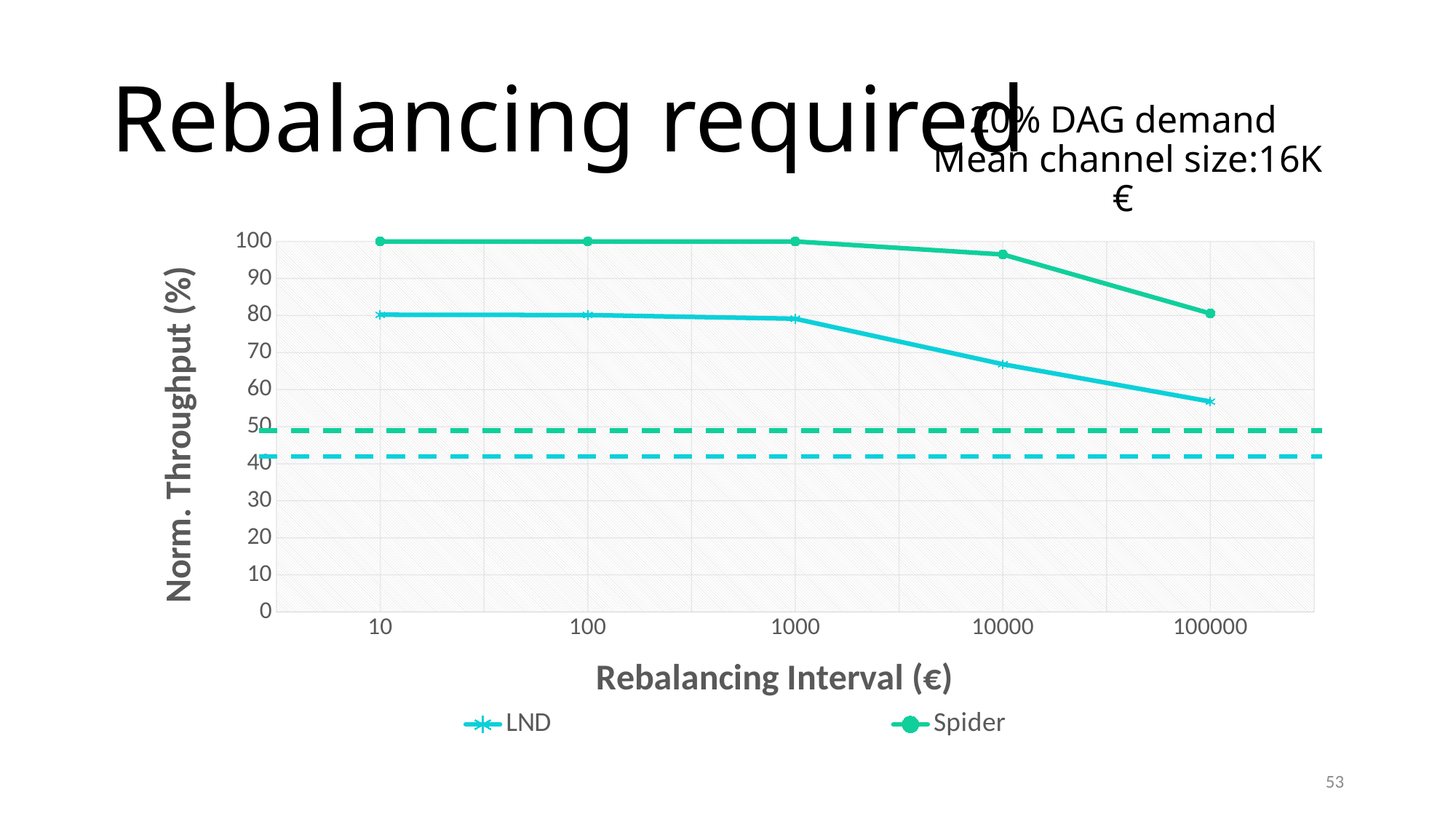
Do the LND values rise or fall as the rebalancing interval increases from 1000 to 100000? fall Is the value for Spider at a rebalancing interval of 10000 greater or less than 90? greater At which rebalancing interval is the Spider series lowest? 100000 Which series has the higher normalized throughput at a rebalancing interval of 10000, LND or Spider? Spider What kind of chart is shown on the slide? line chart How many series does the legend list? 2 Is the value for LND at a rebalancing interval of 100000 greater or less than 60? less What is the label of the y axis? Norm. Throughput (%) What is the normalized throughput for Spider at a rebalancing interval of 10? 100 Is the value for LND at a rebalancing interval of 10000 greater or less than 70? less How many rebalancing interval values are plotted along the x axis? 5